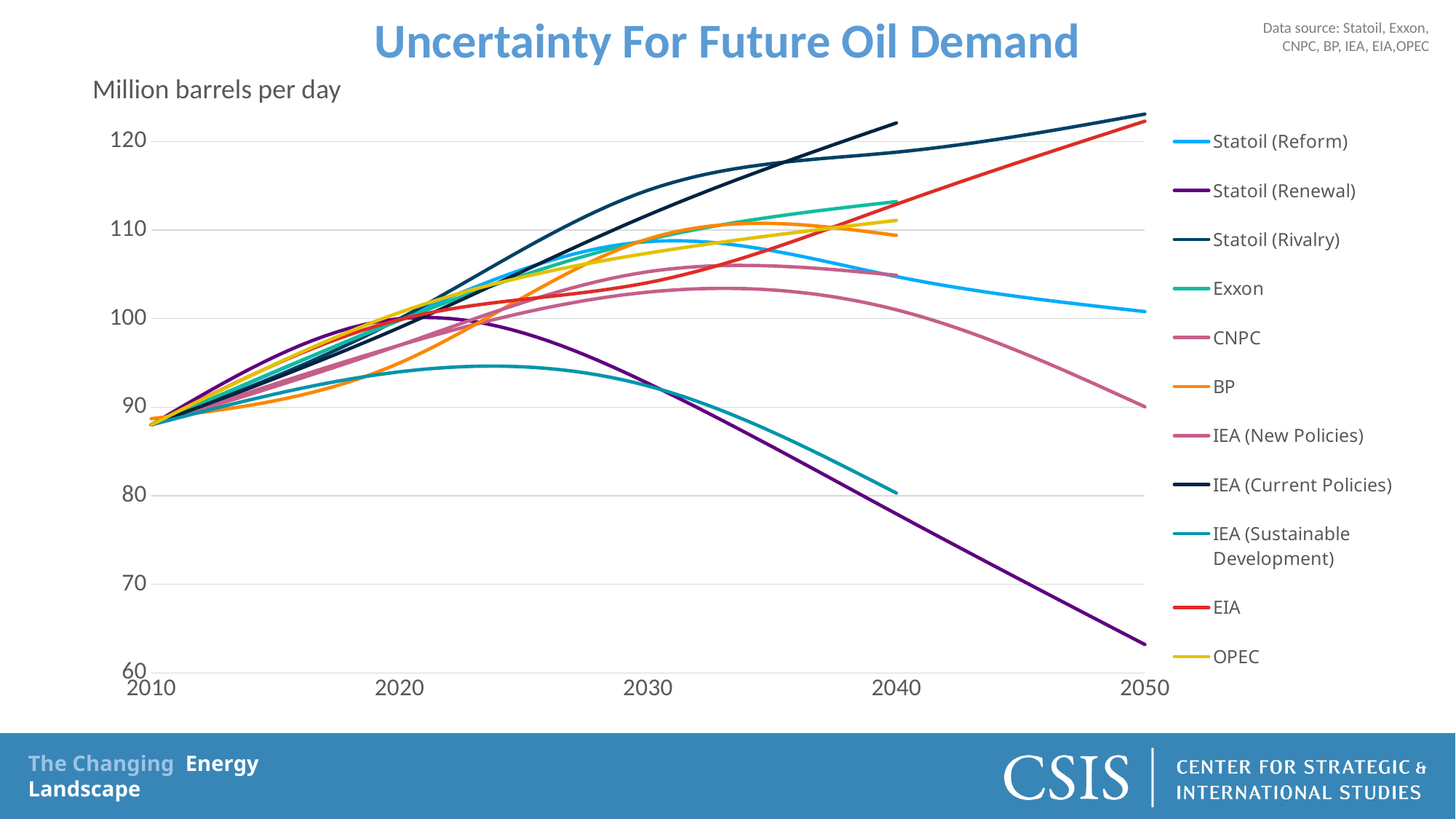
What kind of chart is shown on the slide? line chart What unit is the y axis measured in, according to the label above the chart? Million barrels per day What is the title of the chart? Uncertainty For Future Oil Demand Is the value for Statoil (Rivalry) in 2050 greater or less than 120? greater Is the value for Statoil (Renewal) in 2050 greater or less than 70? less In 2050, which is larger: the value for EIA or the value for CNPC? EIA Is the value for IEA (Sustainable Development) in 2040 greater or less than 90? less How many series does the legend list? 11 Does the Statoil (Rivalry) line rise or fall from 2010 to 2050? rise Which series has the lowest value in 2050? Statoil (Renewal)